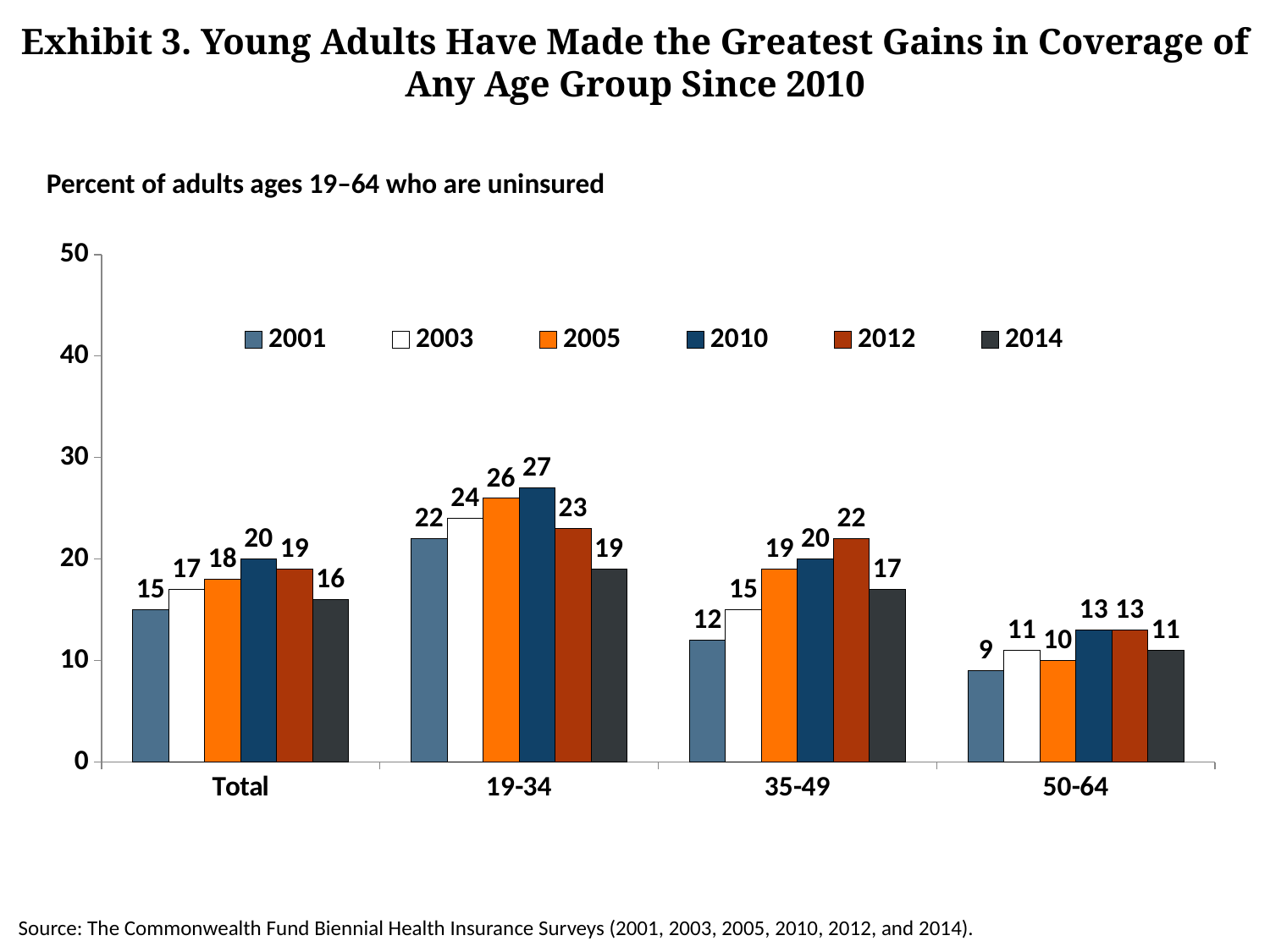
What is the value for Total in 2014? 16 Which is larger for the 35-49 age group: the 2012 value or the 2014 value? 2012 What is the difference between the 2010 and 2014 values for the 19-34 age group? 8 What is the value for the 19-34 age group in 2010? 27 How many age group categories are shown on the x axis? 4 Which age group has the lowest value in 2003? 50-64 What kind of chart is shown on the slide? bar chart What is the subtitle describing the measure plotted on the chart? Percent of adults ages 19–64 who are uninsured What is the value for the 50-64 age group in 2001? 9 For the 35-49 age group, do the values rise or fall from 2001 to 2012? rise How many series does the legend list? 6 Which age group has the highest value in 2012? 19-34